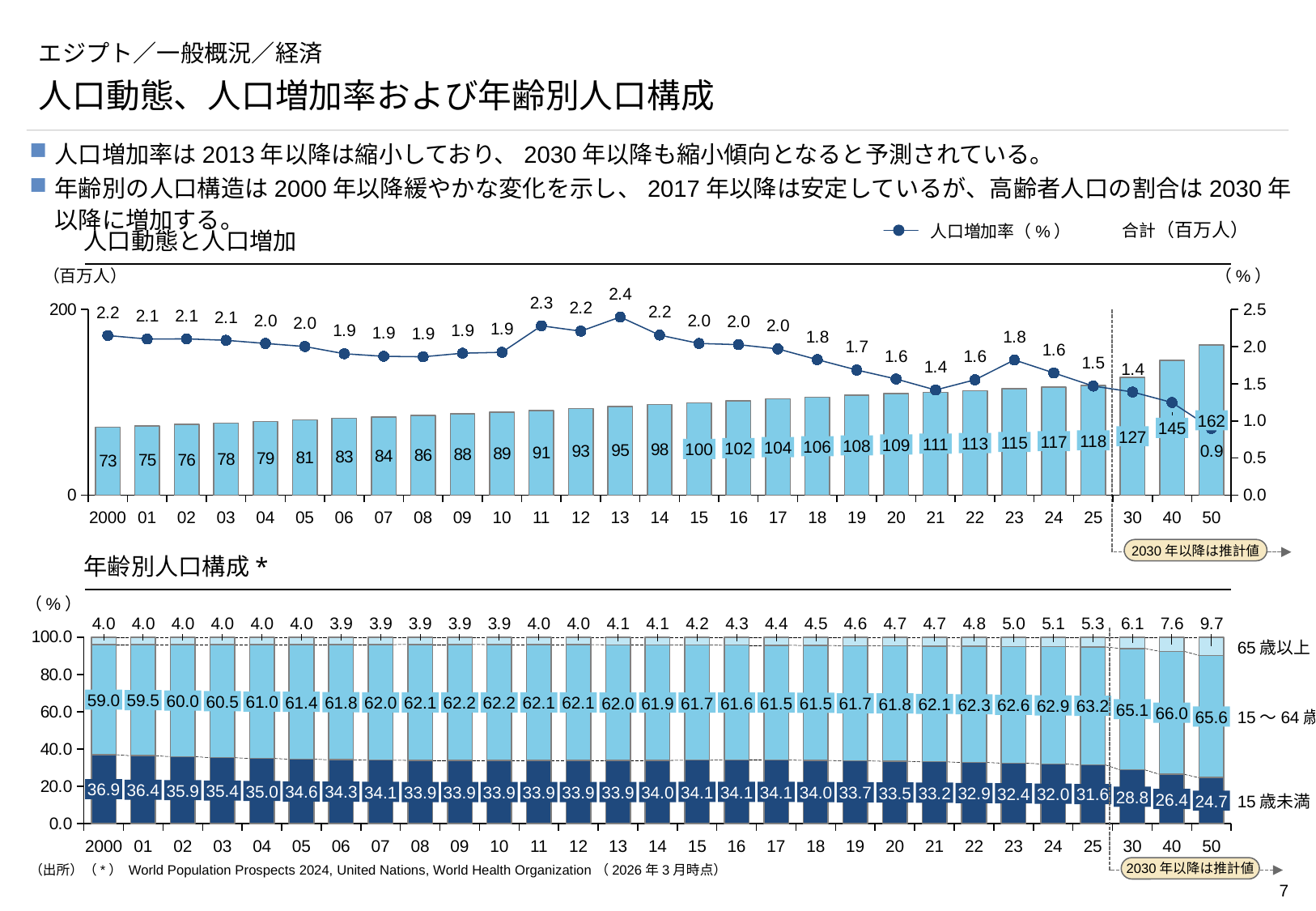
「年齢別人口構成」のグラフで、2050年の65歳以上の割合（%）はいくつですか？ 9.7 「年齢別人口構成」のグラフで、2025年の15歳未満と65歳以上の割合では、どちらが大きいですか？ 15歳未満 「人口動態と人口増加」のグラフで、2000年の合計人口（百万人）はいくつですか？ 73 「人口動態と人口増加」のグラフで、2025年と2000年の合計人口の差（百万人）はいくつですか？ 45 「人口動態と人口増加」のグラフで、人口増加率が最も高い年はどれですか？ 2013 「人口動態と人口増加」のグラフで、2013年の人口増加率（%）はいくつですか？ 2.4 「人口動態と人口増加」のグラフで、2050年の合計人口（百万人）はいくつですか？ 162 「年齢別人口構成」のグラフで、2000年の15歳未満の割合（%）はいくつですか？ 36.9 「人口動態と人口増加」のグラフで、2050年の人口増加率（%）はいくつですか？ 0.9 「年齢別人口構成」のグラフで、15〜64歳の割合が最も高い年はどれですか？ 2040 「年齢別人口構成」のグラフは何種類のグラフですか？ 積み上げ棒グラフ 「人口動態と人口増加」のグラフで、合計人口は2000年から2050年にかけて増加していますか、減少していますか？ 増加